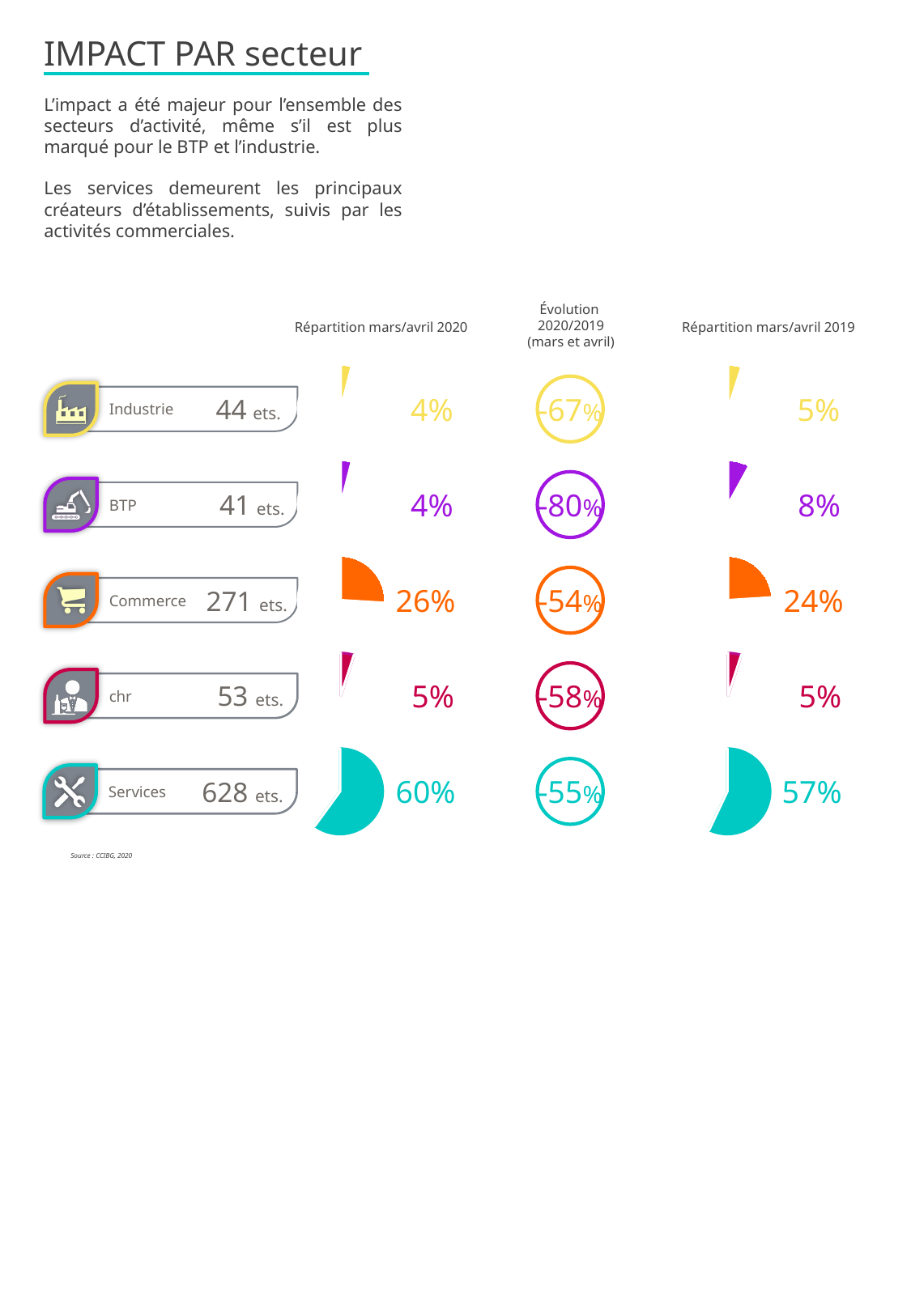
What kind of chart is used to show the 'Répartition mars/avril 2020' shares? Pie chart In the 'Évolution 2020/2019 (mars et avril)' column, what value is shown for BTP? -80% What is the difference between the Services share in 'Répartition mars/avril 2020' and in 'Répartition mars/avril 2019'? 3 percentage points How many sectors are shown on the slide? 5 What is the difference in number of establishments between Services and Commerce? 357 ets. Which sector shows the largest decline in the 'Évolution 2020/2019 (mars et avril)' column? BTP What colour is used for the Commerce sector on the slide? Orange In the 'Répartition mars/avril 2019' column, what share is shown for Commerce? 24% How many establishments (ets.) are shown for Commerce? 271 ets. In the 'Répartition mars/avril 2019' column, which is larger: the share for BTP or the share for Industrie? BTP In the 'Répartition mars/avril 2020' column, what share is shown for Services? 60% Which sector has the largest share in the 'Répartition mars/avril 2020' column? Services